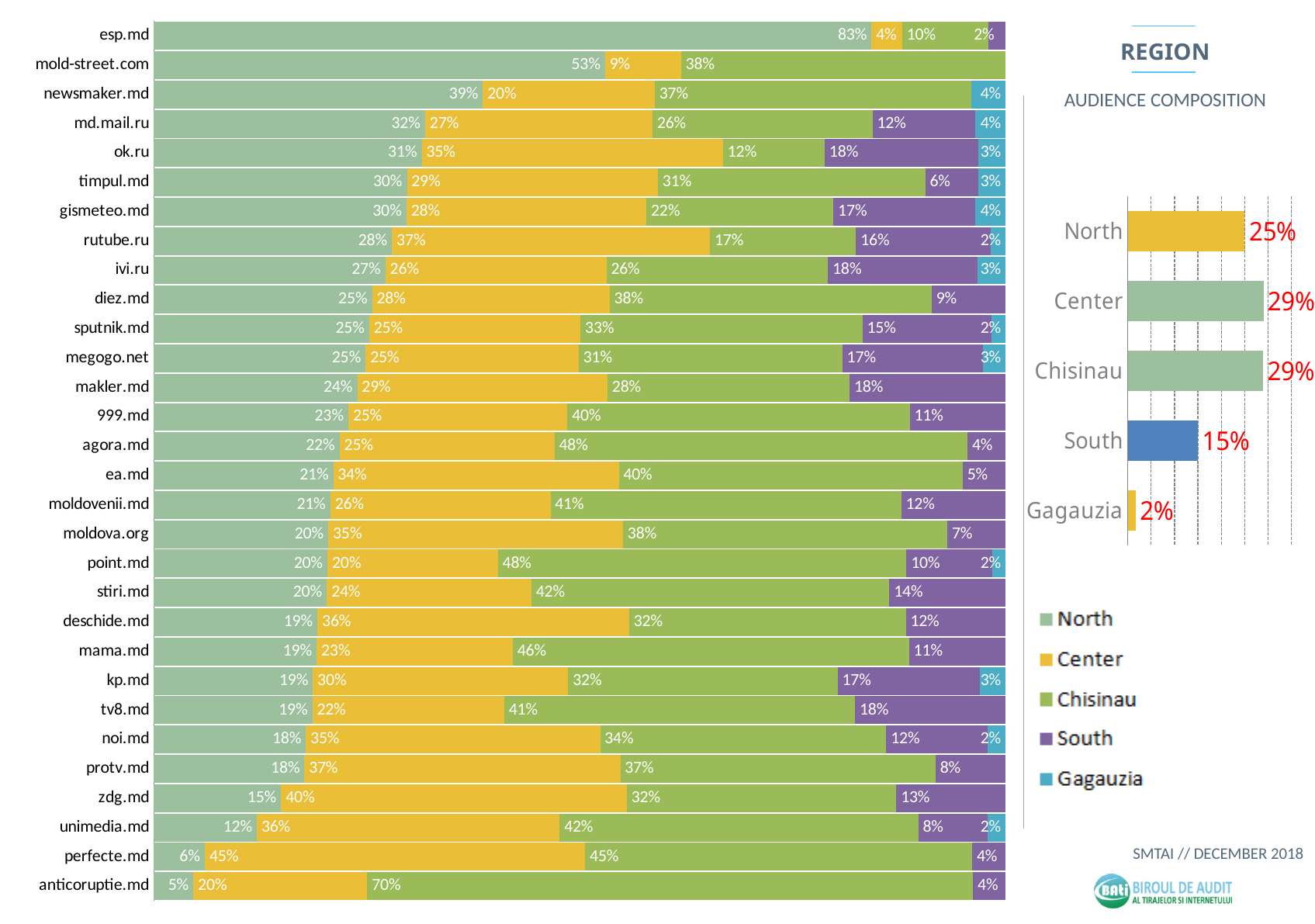
What kind of chart is the REGION chart on the right? Bar chart How many websites are listed in the large stacked chart on the left? 30 In the REGION chart on the right, how many regions are shown? 5 In the large stacked chart on the left, what is the North share for esp.md? 83% In the large stacked chart on the left, which website has the highest North share? esp.md In the large stacked chart on the left, which is larger: the Center share for ok.ru or the Center share for newsmaker.md? ok.ru In the REGION chart on the right, what is the value for North? 25% In the large stacked chart on the left, what is the difference between the North and Center shares for mold-street.com? 44 percentage points In the large stacked chart on the left, what is the Chisinau share for anticoruptie.md? 70% How many series does the legend of the large stacked chart on the left list? 5 In the REGION chart on the right, what is the difference between the values for North and South? 10 percentage points In the REGION chart on the right, which region has the lowest value? Gagauzia